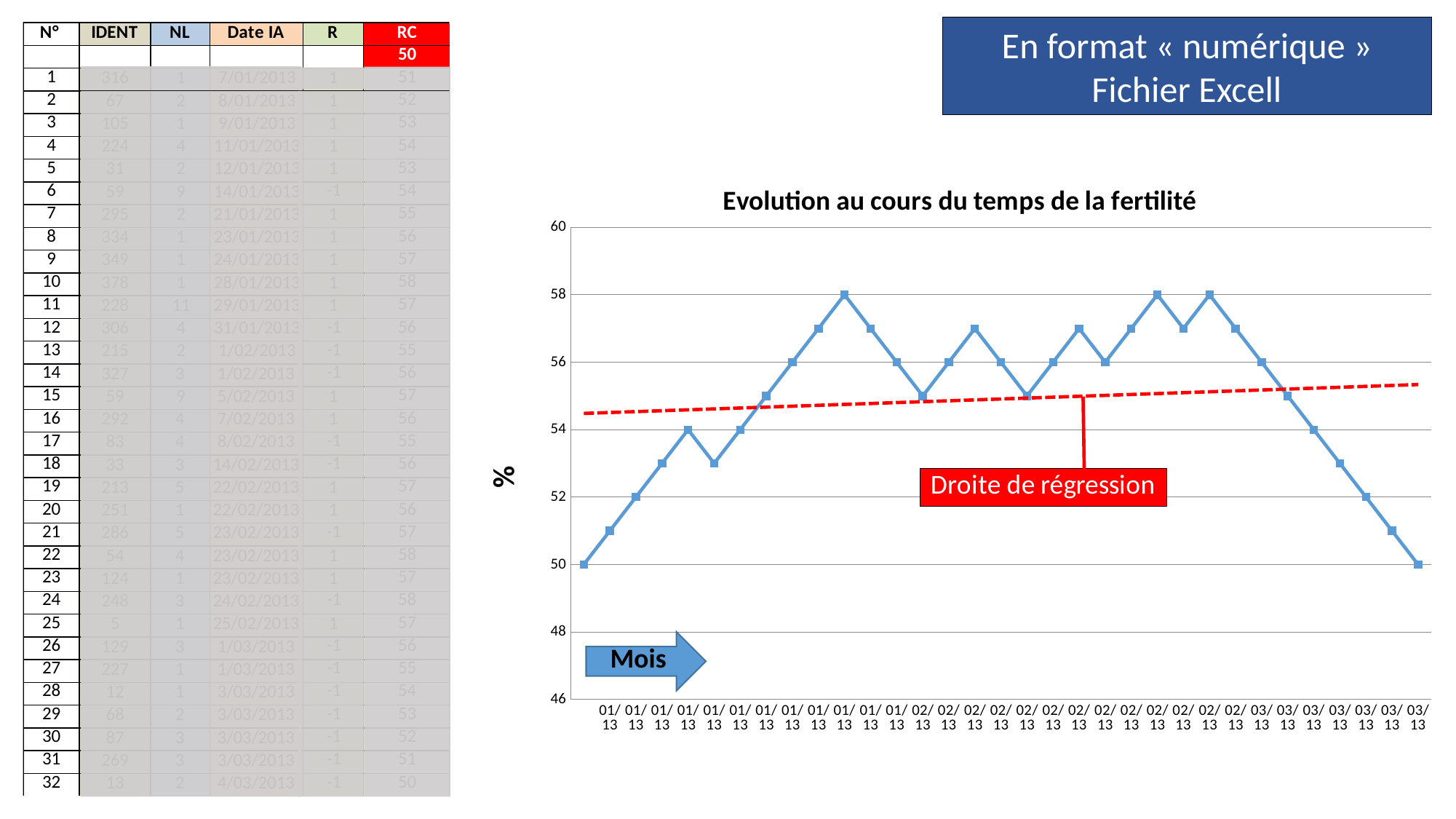
What is the maximum value shown on the vertical axis of the chart? 60 What is the title of the chart on the right of the slide? Evolution au cours du temps de la fertilité What is the value of the first point of the blue line in the chart? 50 What is the highest value reached by the blue line in the chart? 58 Does the blue line rise or fall over the last points of the chart (the 03/13 labels)? fall What is the difference between the highest and lowest values of the blue line in the chart? 8 Is the last point of the blue line greater or less than 52? less What kind of chart is shown under the title 'Evolution au cours du temps de la fertilité'? line chart What is the lowest value reached by the blue line in the chart? 50 What is the value of the last point of the blue line in the chart? 50 What label is given to the red dashed line in the chart? Droite de régression Is the highest value of the blue line greater or less than 56? greater